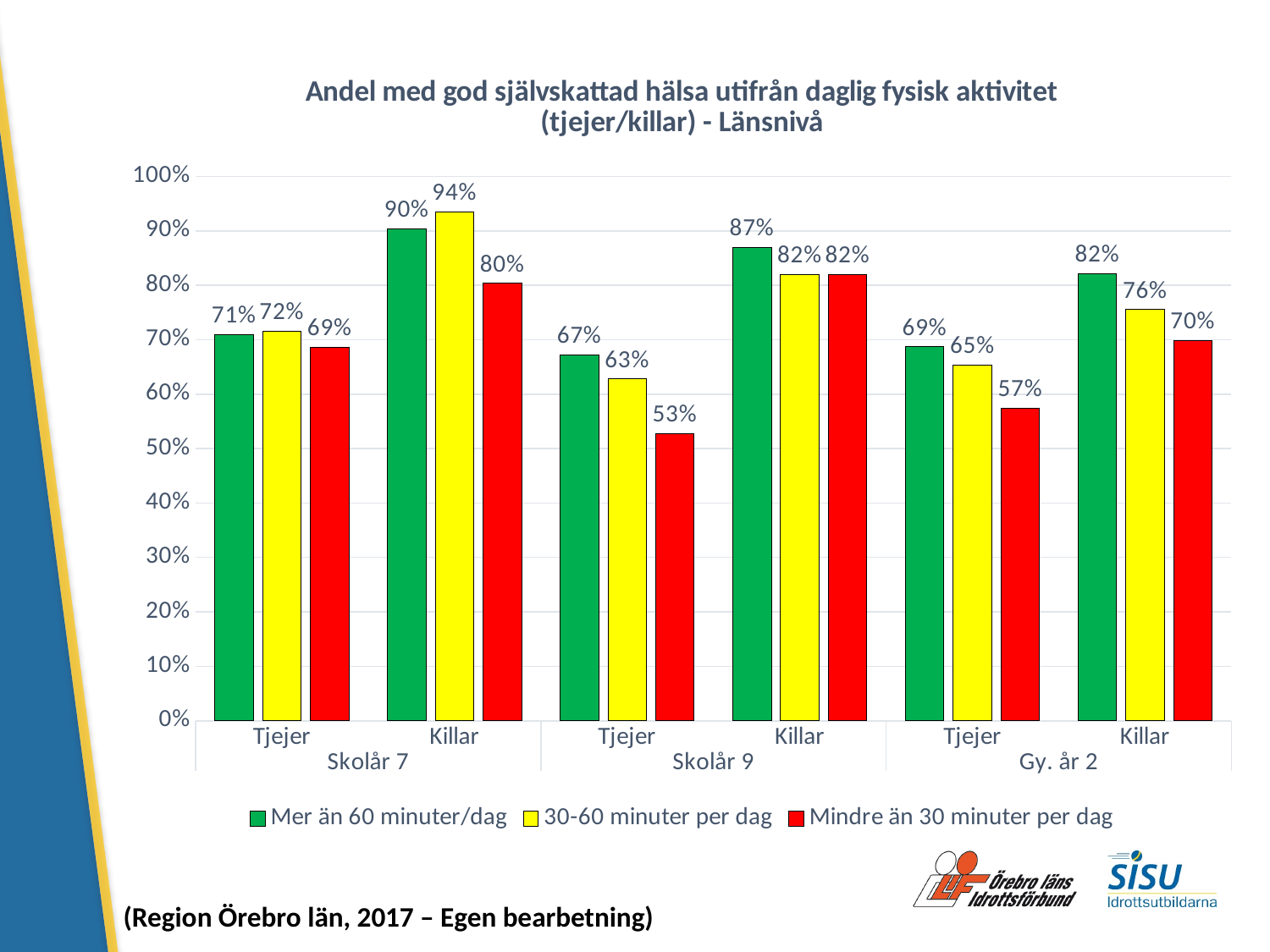
Which colour represents 'Mindre än 30 minuter per dag' in the legend? Red How many groups (category bars clusters) are shown on the x axis? 6 What is the value for 'Mer än 60 minuter/dag' among Killar in Skolår 7? 90% Which is larger for Tjejer in Gy. år 2: 'Mer än 60 minuter/dag' or '30-60 minuter per dag'? Mer än 60 minuter/dag What is the value for '30-60 minuter per dag' among Killar in Gy. år 2? 76% Which group has the highest value for '30-60 minuter per dag'? Killar, Skolår 7 Is the value for 'Mindre än 30 minuter per dag' among Killar in Skolår 9 greater or less than 80%? greater What is the difference between 'Mer än 60 minuter/dag' and 'Mindre än 30 minuter per dag' for Tjejer in Skolår 9? 14 percentage points How many series does the legend list? 3 What kind of chart is shown on the slide? Bar chart What is the value for 'Mindre än 30 minuter per dag' among Tjejer in Skolår 9? 53% Which group has the lowest value for 'Mindre än 30 minuter per dag'? Tjejer, Skolår 9